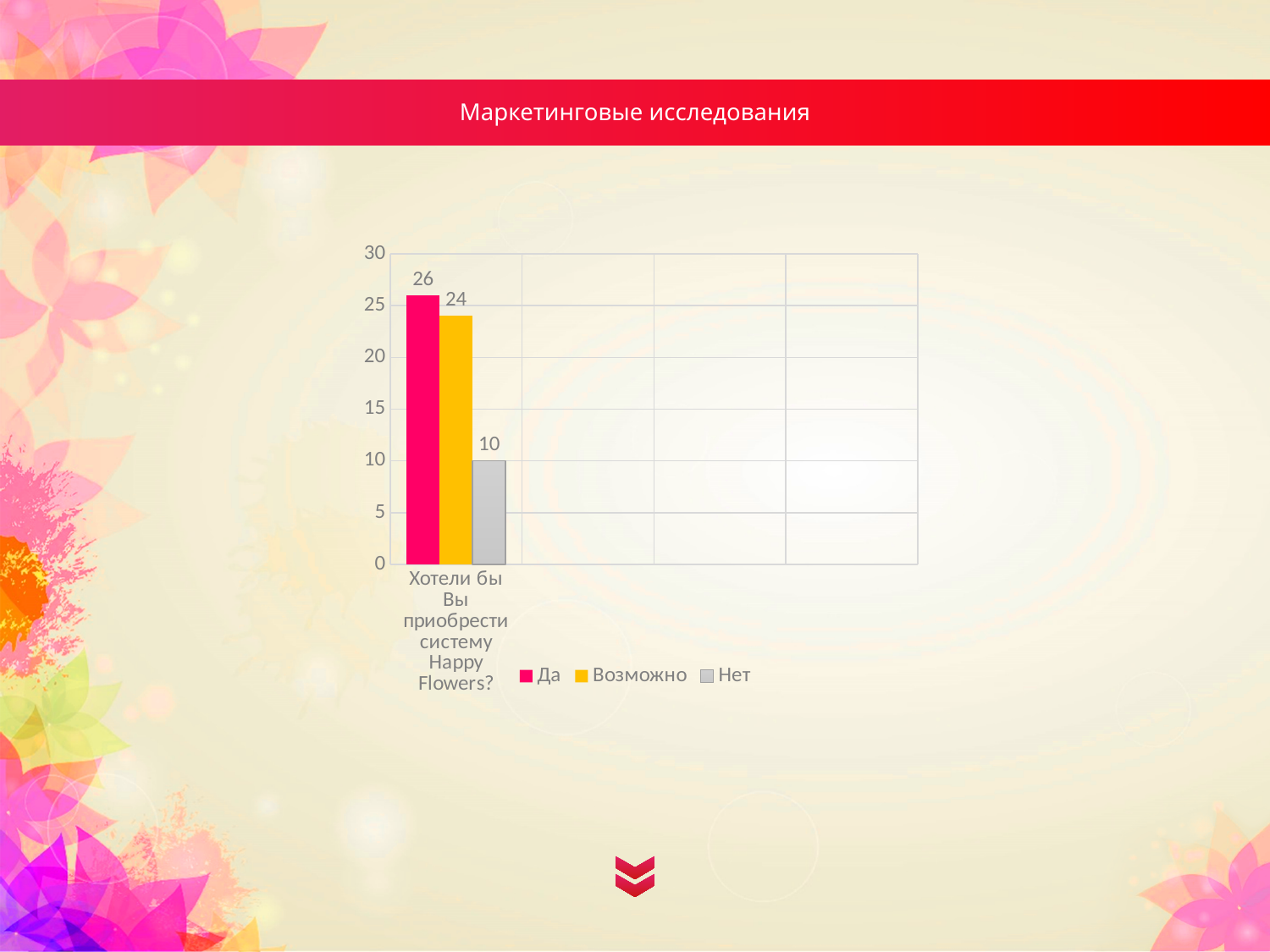
Which series has the lowest value? Нет Is the value for "Нет" greater or less than 15? less What kind of chart is shown on the slide? bar chart Which is larger, the value for "Возможно" or the value for "Нет"? Возможно What is the difference between the values for "Да" and "Нет"? 16 How many series does the legend list? 3 What is the value for the "Нет" series? 10 Which series has the highest value? Да What is the value for the "Возможно" series? 24 What is the value for the "Да" series? 26 What is the difference between the values for "Да" and "Возможно"? 2 What is the title of the slide? Маркетинговые исследования